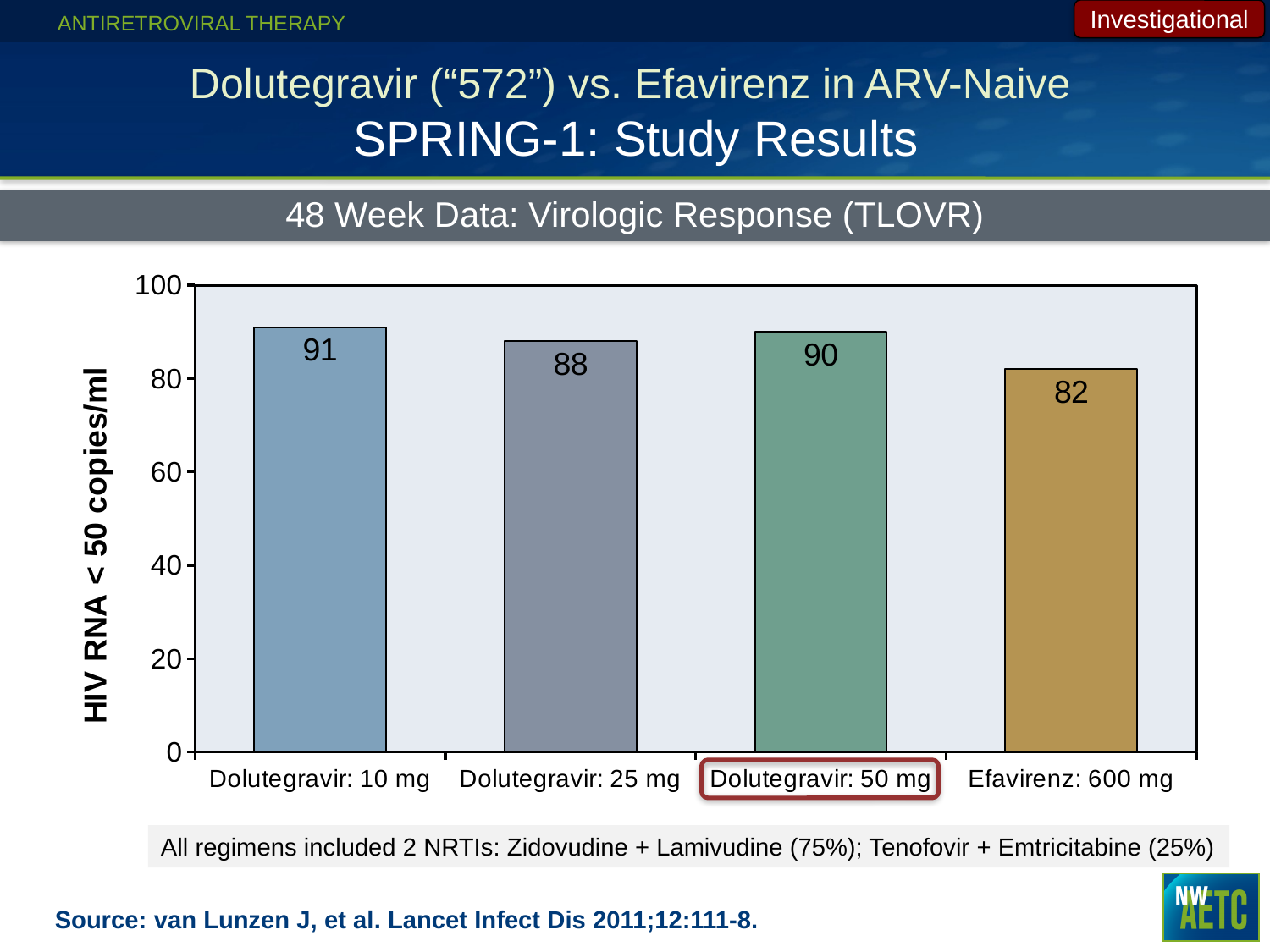
Which is larger, the value for Dolutegravir: 25 mg or the value for Efavirenz: 600 mg? Dolutegravir: 25 mg What is the value for Dolutegravir: 50 mg? 90 What is the value for Dolutegravir: 25 mg? 88 What kind of chart is shown on the slide? Bar chart What is the value for Dolutegravir: 10 mg? 91 What is the label of the y axis? HIV RNA < 50 copies/ml Which category has the lowest value? Efavirenz: 600 mg Which category has the highest value? Dolutegravir: 10 mg How many categories are shown on the x axis? 4 What is the value for Efavirenz: 600 mg? 82 Which category label is outlined with a red box? Dolutegravir: 50 mg What is the difference between the values for Dolutegravir: 50 mg and Efavirenz: 600 mg? 8